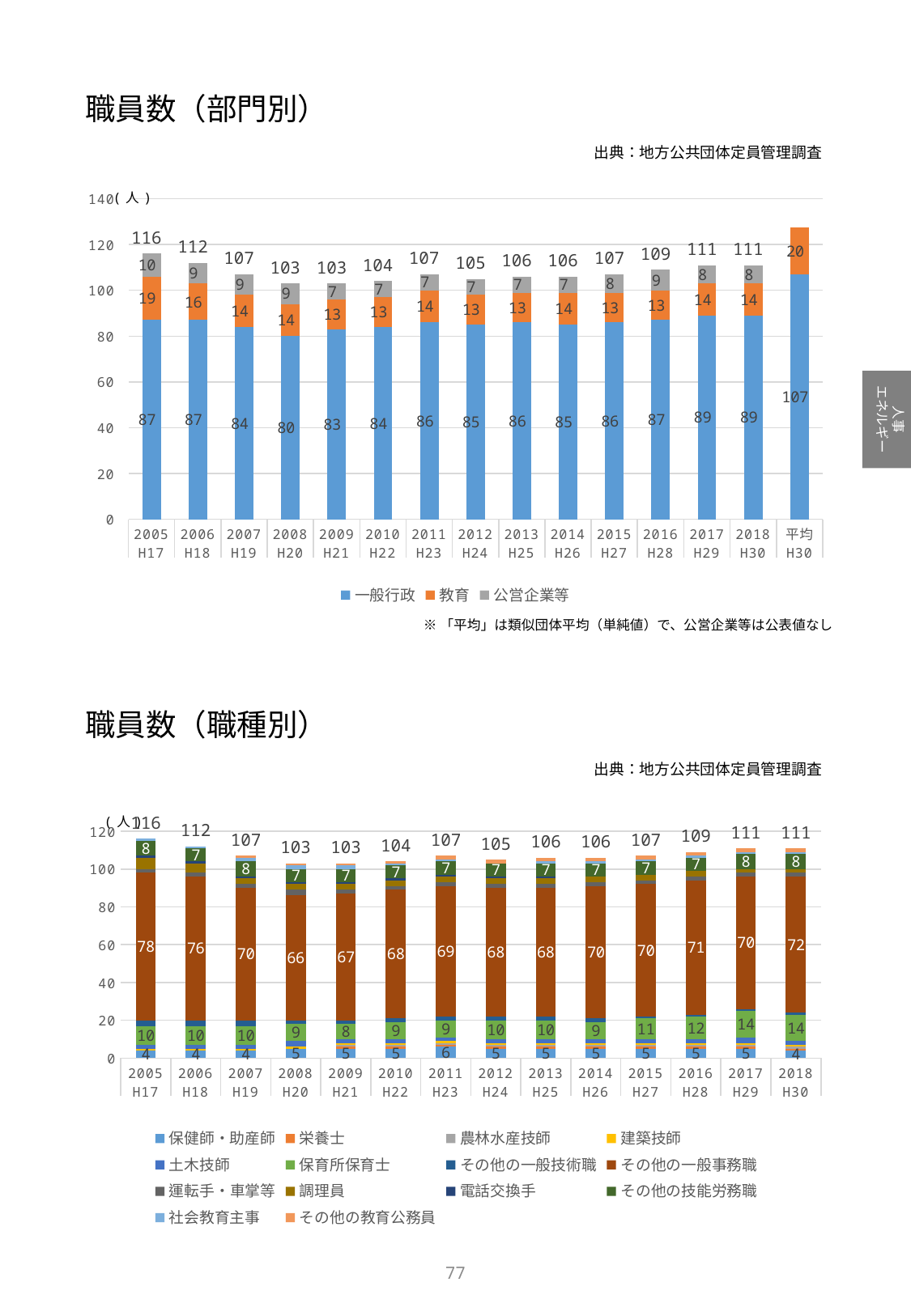
In the 職員数（部門別） chart, how many series does the legend list? 3 In the 職員数（部門別） chart, which year has the lowest 一般行政 value? 2008 H20 What kind of chart is 職員数（職種別）? stacked bar chart In the 職員数（職種別） chart, what is the その他の一般事務職 value for 2008 H20? 66 In the 職員数（部門別） chart, is the 一般行政 value for 2017 H29 larger or smaller than the value for 2012 H24? larger In the 職員数（職種別） chart, which year has the highest その他の一般事務職 value? 2005 H17 In the 職員数（部門別） chart, what is the 一般行政 value for 2005 H17? 87 In the 職員数（部門別） chart, what is the difference between the 教育 values for 2005 H17 and 2006 H18? 3 In the 職員数（部門別） chart, what is the 教育 value for 平均 H30? 20 In the 職員数（職種別） chart, how many year categories are shown on the x axis? 14 In the 職員数（職種別） chart, how many series does the legend list? 14 In the 職員数（部門別） chart, what is the total of the stacked bar for 2008 H20? 103